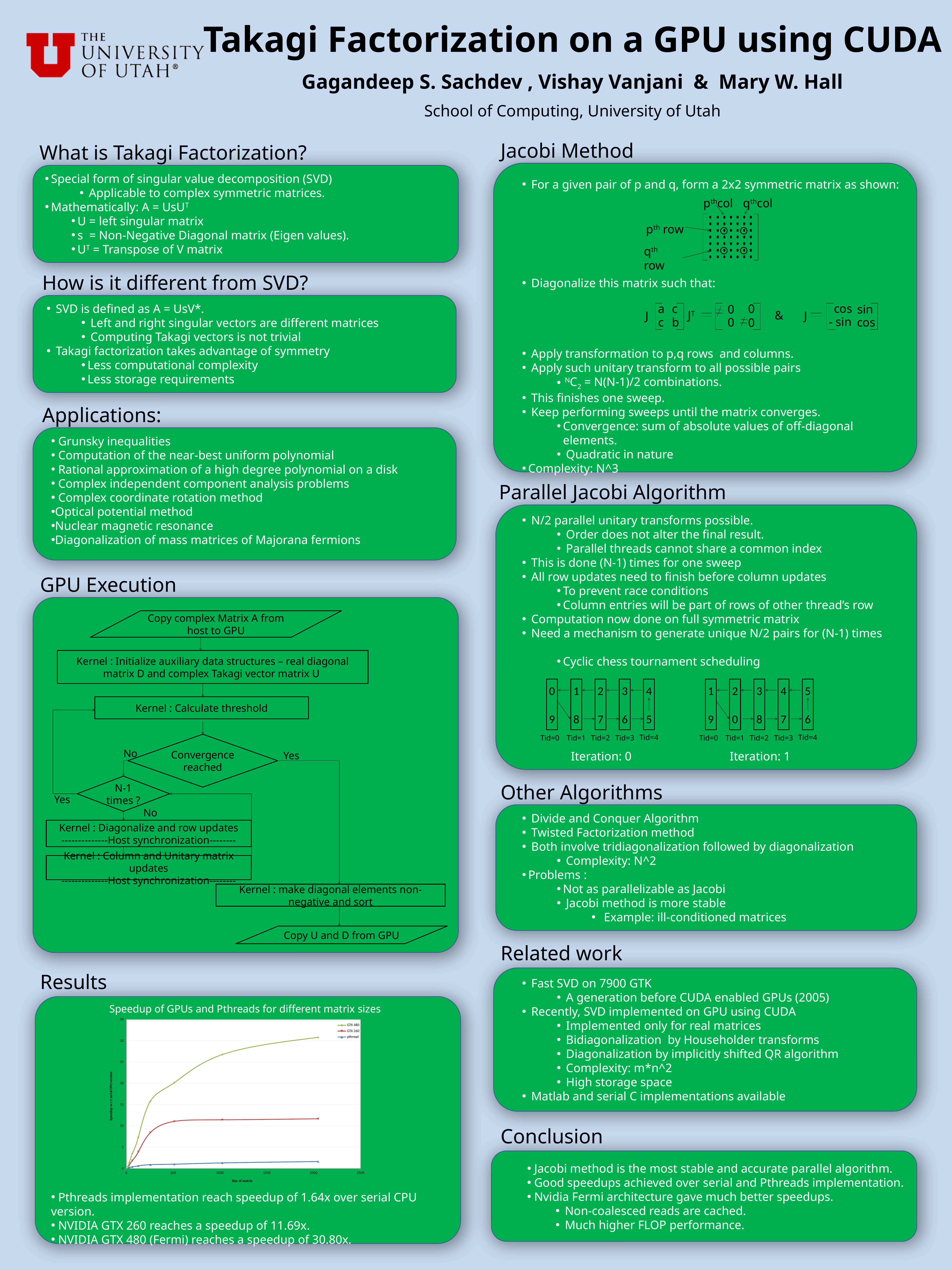
How many series does the legend of the speedup chart list? 3 In the speedup chart, which series is higher at a matrix size of 2000: GTX 480 or GTX 260? GTX 480 What kind of chart is shown in the Results section? line chart Which series in the speedup chart has the lowest speedup across the matrix sizes? pthread Which series in the speedup chart reaches the highest speedup at the largest matrix size? GTX 480 In the speedup chart, is the GTX 260 speedup at a matrix size of 2000 greater or less than 15? less In the speedup chart, is the pthread speedup at a matrix size of 2000 greater or less than 5? less In the speedup chart, does the GTX 480 speedup rise or fall as the matrix size increases? rise What are the three legend entries of the speedup chart? GTX 480, GTX 260, pthread In the speedup chart, is the GTX 260 speedup at a matrix size of 2000 greater or less than 10? greater What is the title of the chart in the Results section? Speedup of GPUs and Pthreads for different matrix sizes